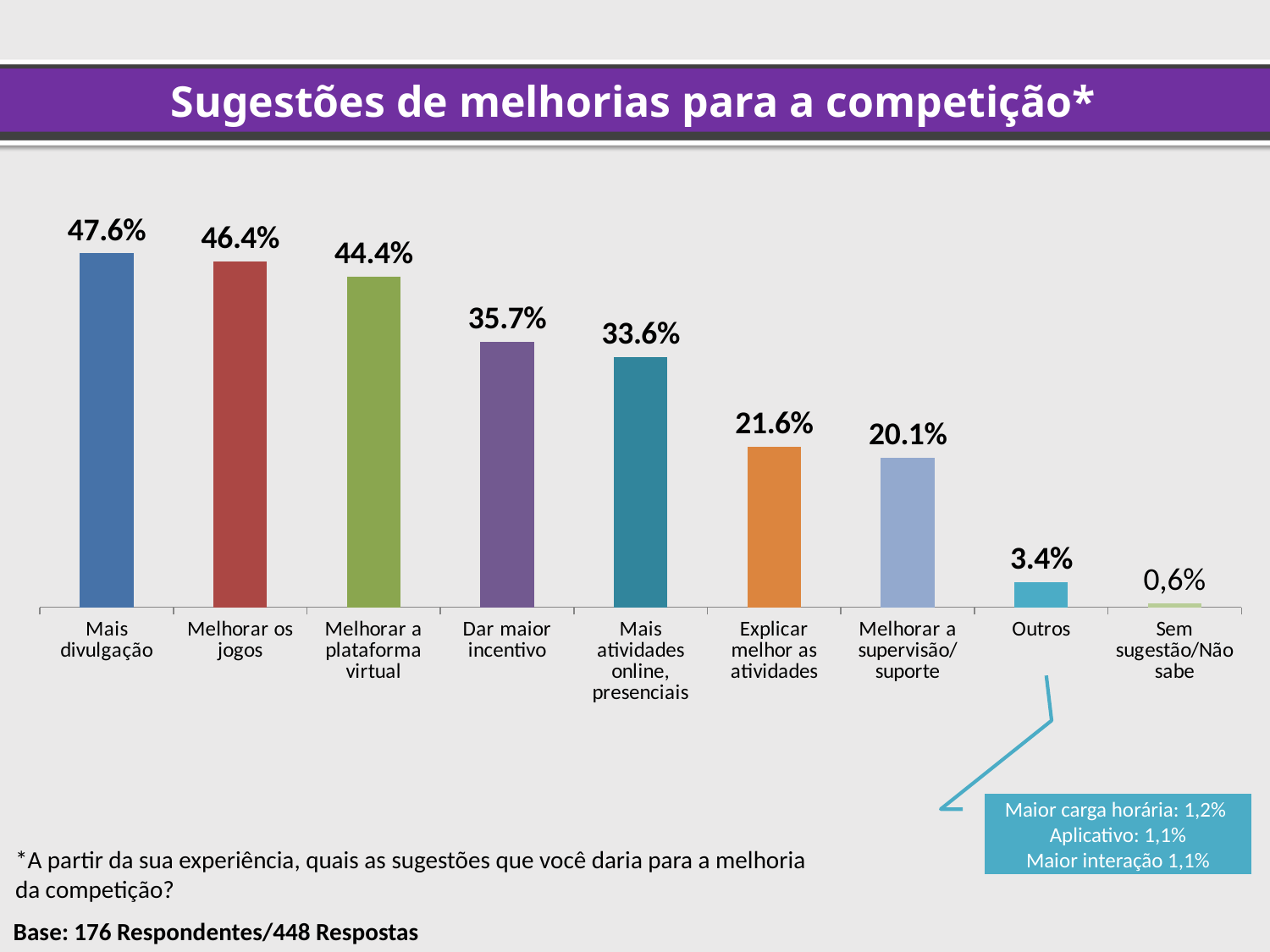
Which is larger, "Explicar melhor as atividades" or "Melhorar a supervisão/suporte"? Explicar melhor as atividades Which category has the highest value? Mais divulgação Do the values rise or fall from left to right along the x axis? Fall Which category has the lowest value? Sem sugestão/Não sabe What is the value for "Melhorar a supervisão/suporte"? 20.1% What is the value for "Dar maior incentivo"? 35.7% How many categories are shown in the chart? 9 What is the value for "Sem sugestão/Não sabe"? 0,6% What is the difference between "Dar maior incentivo" and "Mais atividades online, presenciais"? 2.1 percentage points What is the difference between "Mais divulgação" and "Melhorar os jogos"? 1.2 percentage points What is the value for "Mais divulgação"? 47.6% What kind of chart is shown on the slide? Bar chart